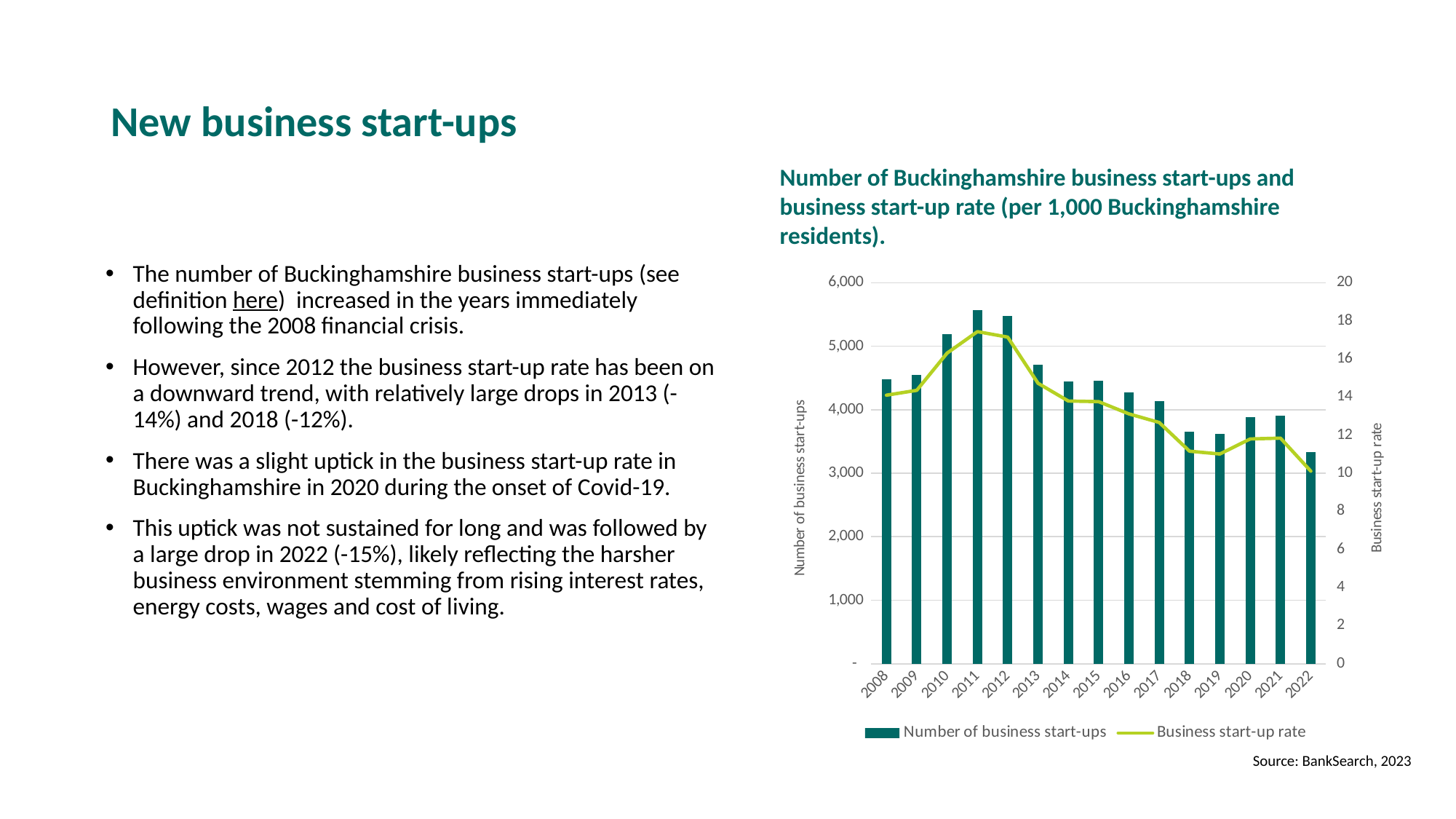
In which year was the number of business start-ups lowest? 2022 Is the business start-up rate in 2011 greater or less than 16? greater How many series does the chart legend list? 2 What kind of chart is shown on the slide? A combined bar and line chart Does the business start-up rate generally rise or fall from 2012 to 2022? fall In which year was the number of business start-ups highest? 2011 How many years are shown on the x axis of the chart? 15 Is the number of business start-ups in 2018 greater or less than 4,000? less What is the label of the right-hand vertical axis of the chart? Business start-up rate In which year was the business start-up rate highest? 2011 Which year had more business start-ups, 2010 or 2013? 2010 Is the number of business start-ups in 2011 greater or less than 5,000? greater